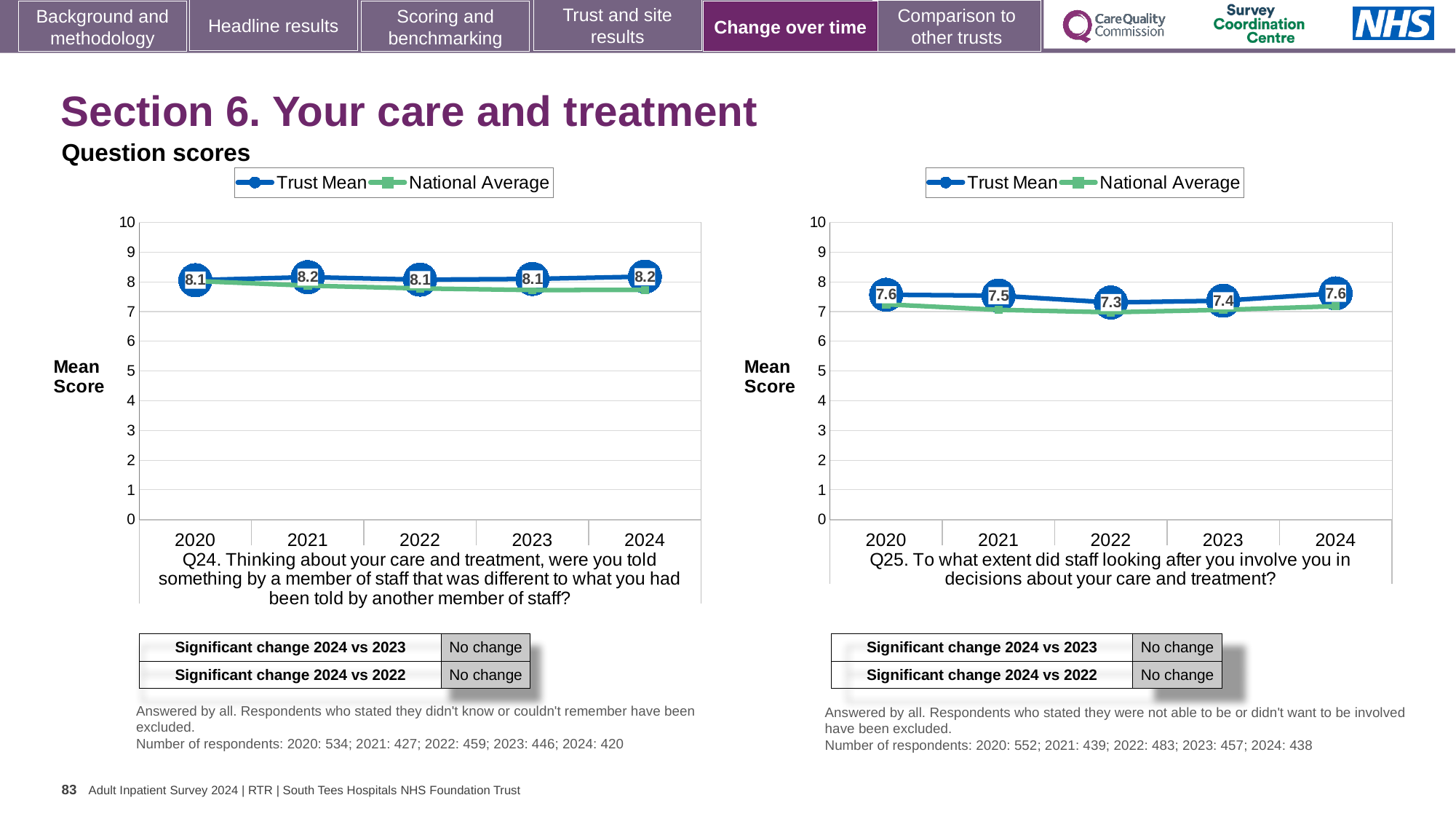
How many years are plotted on the x axis of the Q24 chart on the left? 5 In the Q25 chart on the right, which is larger: the Trust Mean for 2020 or for 2022? 2020 In the Q25 chart on the right, what is the difference between the Trust Mean scores for 2024 and 2022? 0.3 In the Q25 chart on the right, what is the Trust Mean score for 2022? 7.3 In the Q24 chart on the left, what is the Trust Mean score for 2021? 8.2 What is the label on the y axis of the Q25 chart on the right? Mean Score In the Q25 chart on the right, what is the Trust Mean score for 2024? 7.6 In the Q25 chart on the right, which year has the lowest Trust Mean score? 2022 What kind of chart is the Q24 chart on the left? Line chart In the Q24 chart on the left, is the National Average value for 2020 greater or less than 7? greater In the Q24 chart on the left, what is the Trust Mean score for 2020? 8.1 How many series does the legend of the Q25 chart on the right list? 2